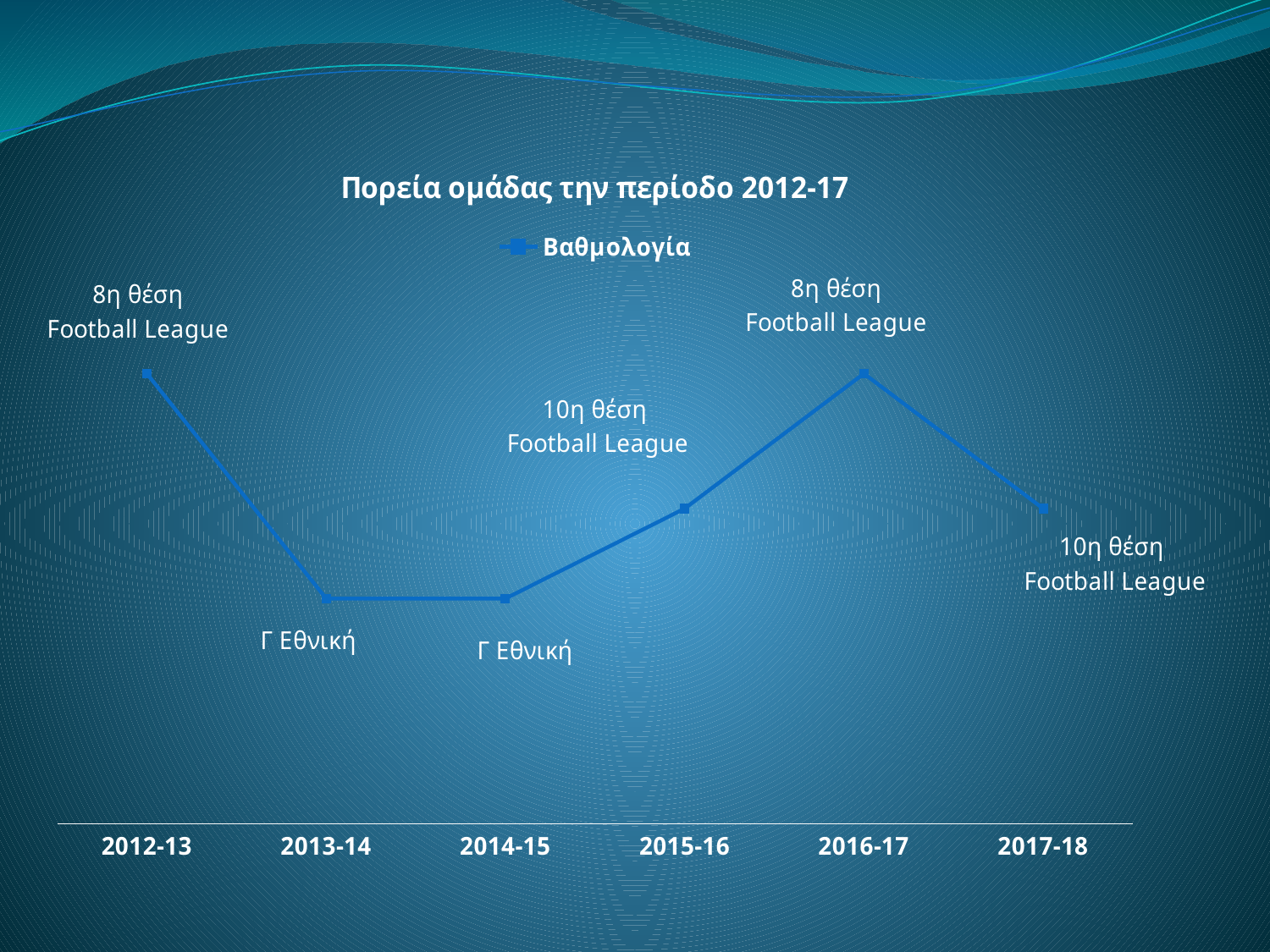
Does the line rise or fall from 2014-15 to 2016-17? rise What is the data label for the 2017-18 season? 10η θέση Football League How many seasons are shown on the x axis? 6 What is the name of the series shown in the legend? Βαθμολογία What is the data label for the 2016-17 season? 8η θέση Football League What is the data label for the 2015-16 season? 10η θέση Football League What is the data label for the 2013-14 season? Γ Εθνική What is the data label for the 2012-13 season? 8η θέση Football League Does the line rise or fall from 2012-13 to 2013-14? fall What kind of chart is shown on the slide? line chart How many series does the legend list? 1 What is the title of the chart? Πορεία ομάδας την περίοδο 2012-17